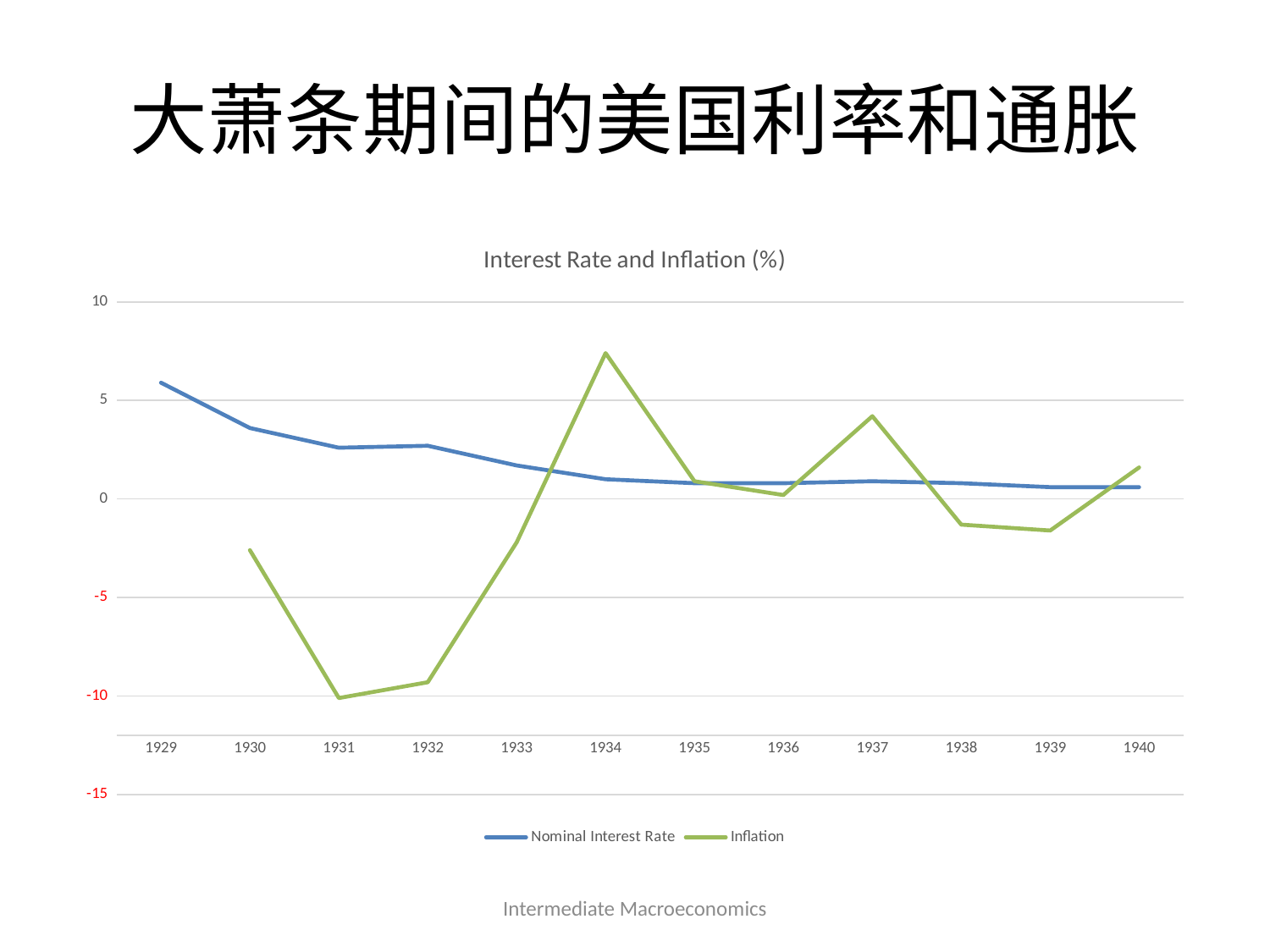
In which year is the Nominal Interest Rate highest? 1929 How many years are plotted along the x axis? 12 In which year is Inflation highest? 1934 Is the Inflation value for 1931 greater or less than -5? less What kind of chart is shown on the slide? line chart Which series is drawn in green? Inflation Is the Nominal Interest Rate for 1929 greater or less than 5? greater Does the Nominal Interest Rate generally rise or fall from 1929 to 1940? fall In 1931, which is larger: the Nominal Interest Rate or Inflation? Nominal Interest Rate How many series does the legend list? 2 Is the Inflation value for 1934 greater or less than 5? greater What is the title of the chart? Interest Rate and Inflation (%)